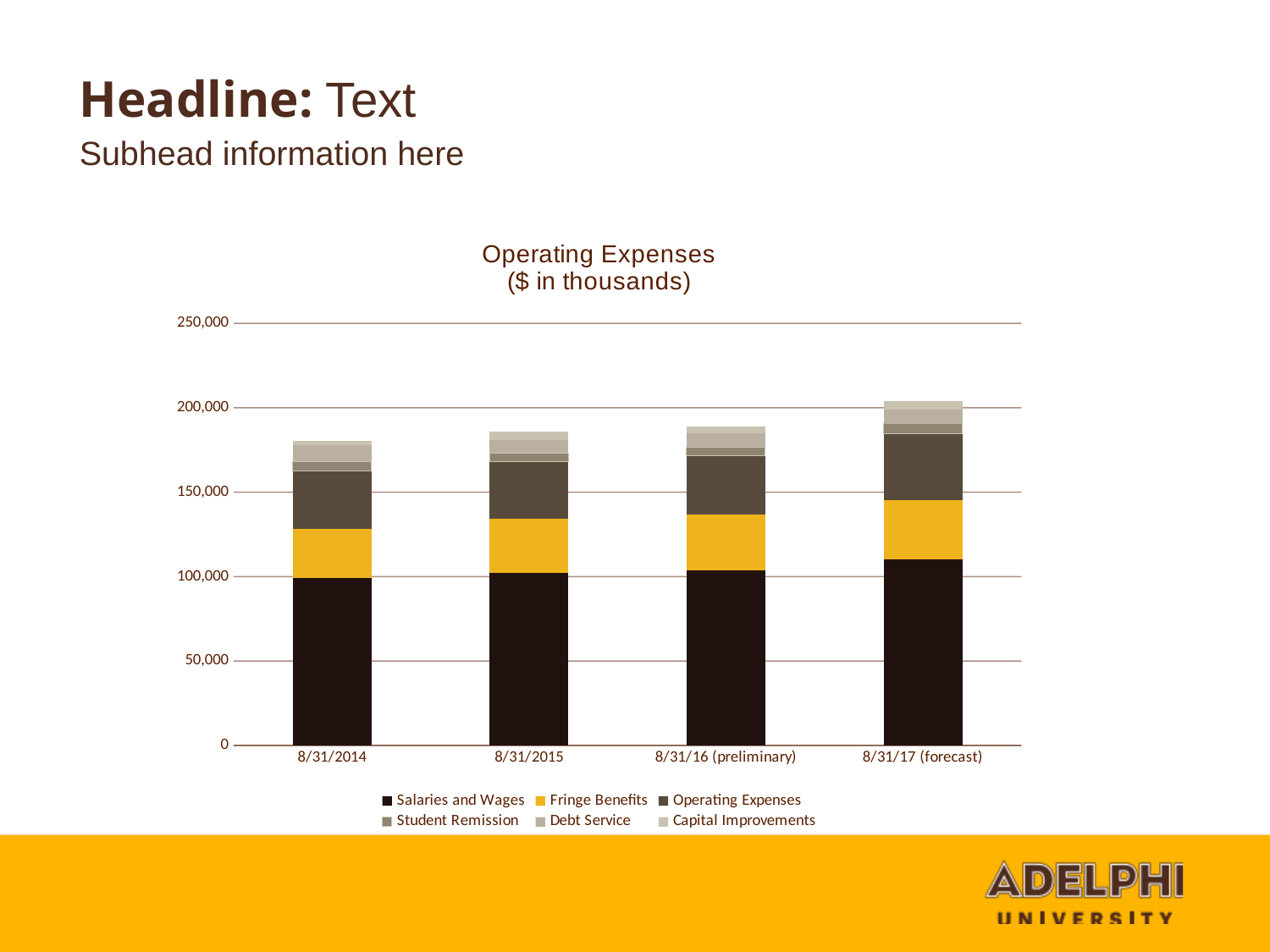
Which has the larger total stacked bar, 8/31/2014 or 8/31/17 (forecast)? 8/31/17 (forecast) How many series does the chart's legend list? 6 Which date has the shortest total stacked bar? 8/31/2014 Do the total operating expenses rise or fall from 8/31/2014 to 8/31/17 (forecast)? Rise Which date has the tallest total stacked bar? 8/31/17 (forecast) How many categories (dates) are shown on the x axis of the chart? 4 Is the total stacked bar for 8/31/2015 greater or less than 150,000? greater Is the Salaries and Wages segment for 8/31/17 (forecast) greater or less than 100,000? greater Which series forms the bottom segment of each stacked bar? Salaries and Wages What is the title of the chart? Operating Expenses ($ in thousands) What kind of chart is shown on the slide? Stacked bar chart Is the total stacked bar for 8/31/2014 greater or less than 200,000? less